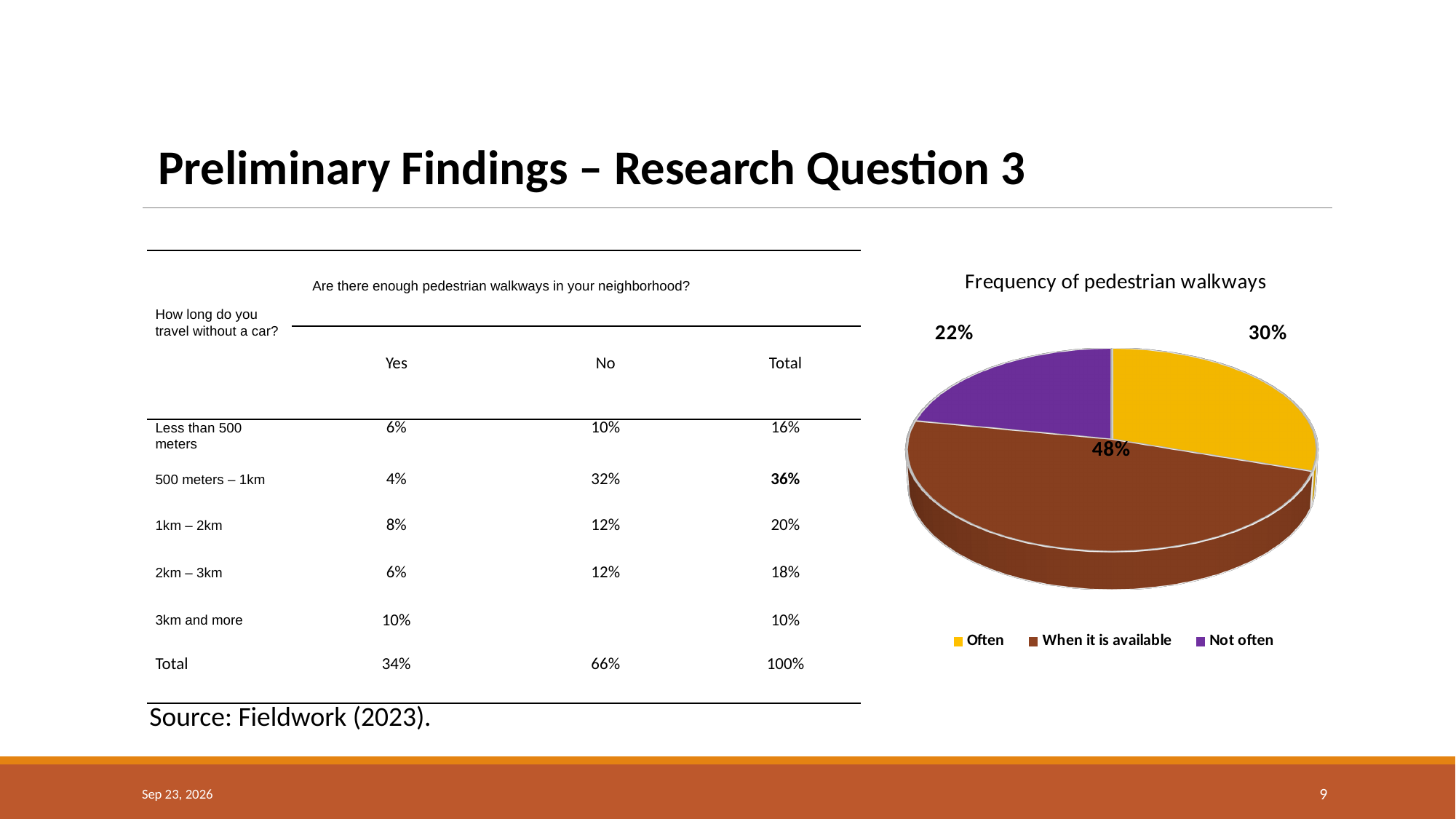
Which slice of the pie chart is the largest? When it is available In the pie chart, what share is labelled for "Often"? 30% What is the title of the pie chart? Frequency of pedestrian walkways In the pie chart, which is larger: the "Often" slice or the "Not often" slice? Often In the pie chart, what share is labelled for "When it is available"? 48% What kind of chart is shown on the slide? Pie chart Which slice of the pie chart is the smallest? Not often What colour is the "Not often" slice in the pie chart? Purple In the pie chart, what share is labelled for "Not often"? 22% How many entries does the pie chart's legend list? 3 How many slices does the pie chart have? 3 In the pie chart, what is the difference between the "When it is available" share and the "Often" share? 18%